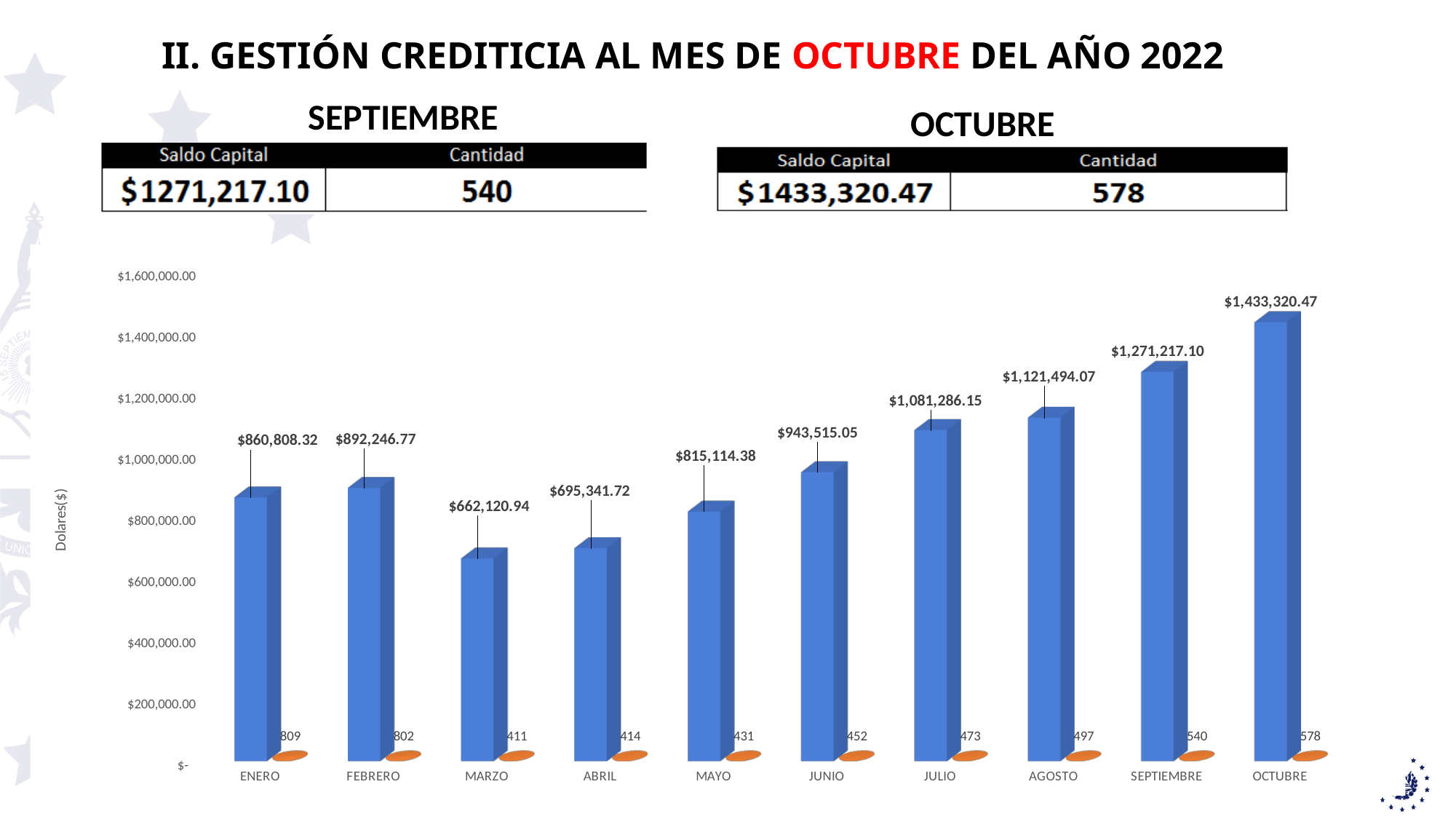
How many months are shown on the x axis of the bar chart? 10 Is the value for MAYO greater or less than $1,000,000.00? less What is the value for MARZO in the bar chart? $662,120.94 Which month has the highest value in the bar chart? OCTUBRE Which month has the lowest value in the bar chart? MARZO What kind of chart is shown on the slide? bar chart Do the values rise or fall from MARZO to OCTUBRE? rise Which is larger, the value for ENERO or the value for FEBRERO? FEBRERO What number is shown next to the OCTUBRE bar at the bottom of the chart? 578 What is the label on the vertical axis of the chart? Dolares($) What is the value for SEPTIEMBRE in the bar chart? $1,271,217.10 What is the difference between the values for OCTUBRE and SEPTIEMBRE? $162,103.37